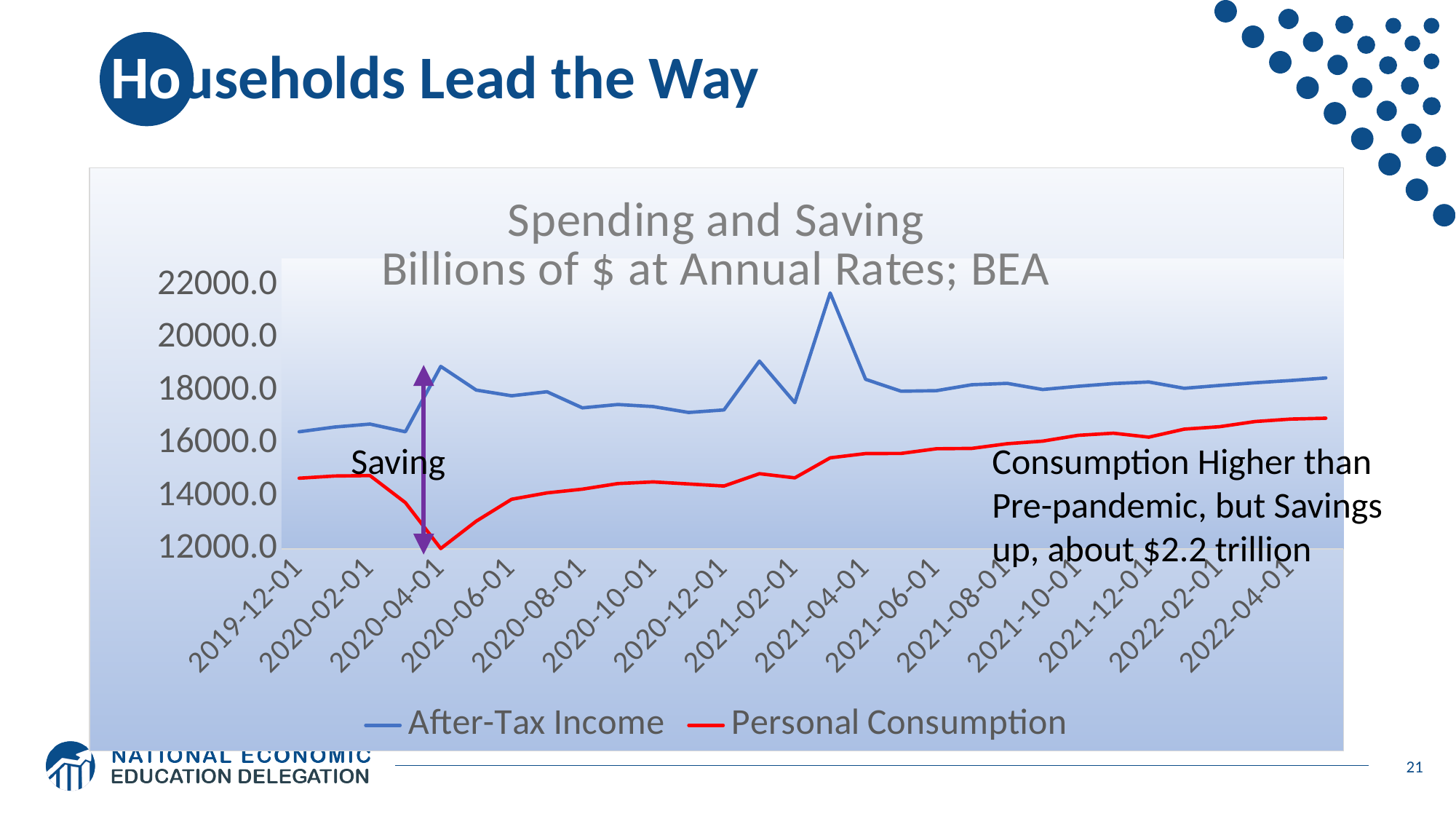
Which series has the higher values throughout the chart, After-Tax Income or Personal Consumption? After-Tax Income Is the value for Personal Consumption at 2019-12-01 greater or less than 14000? greater Is the value for Personal Consumption at 2022-04-01 greater or less than 16000? greater What kind of chart is shown on the slide? Line chart What is the title of the chart? Spending and Saving Billions of $ at Annual Rates; BEA Which series is drawn in red? Personal Consumption Is the value for Personal Consumption at 2020-12-01 greater or less than 16000? less How many date labels are shown on the x axis? 15 Does Personal Consumption rise or fall from 2020-06-01 to 2022-04-01? rise How many series does the legend list? 2